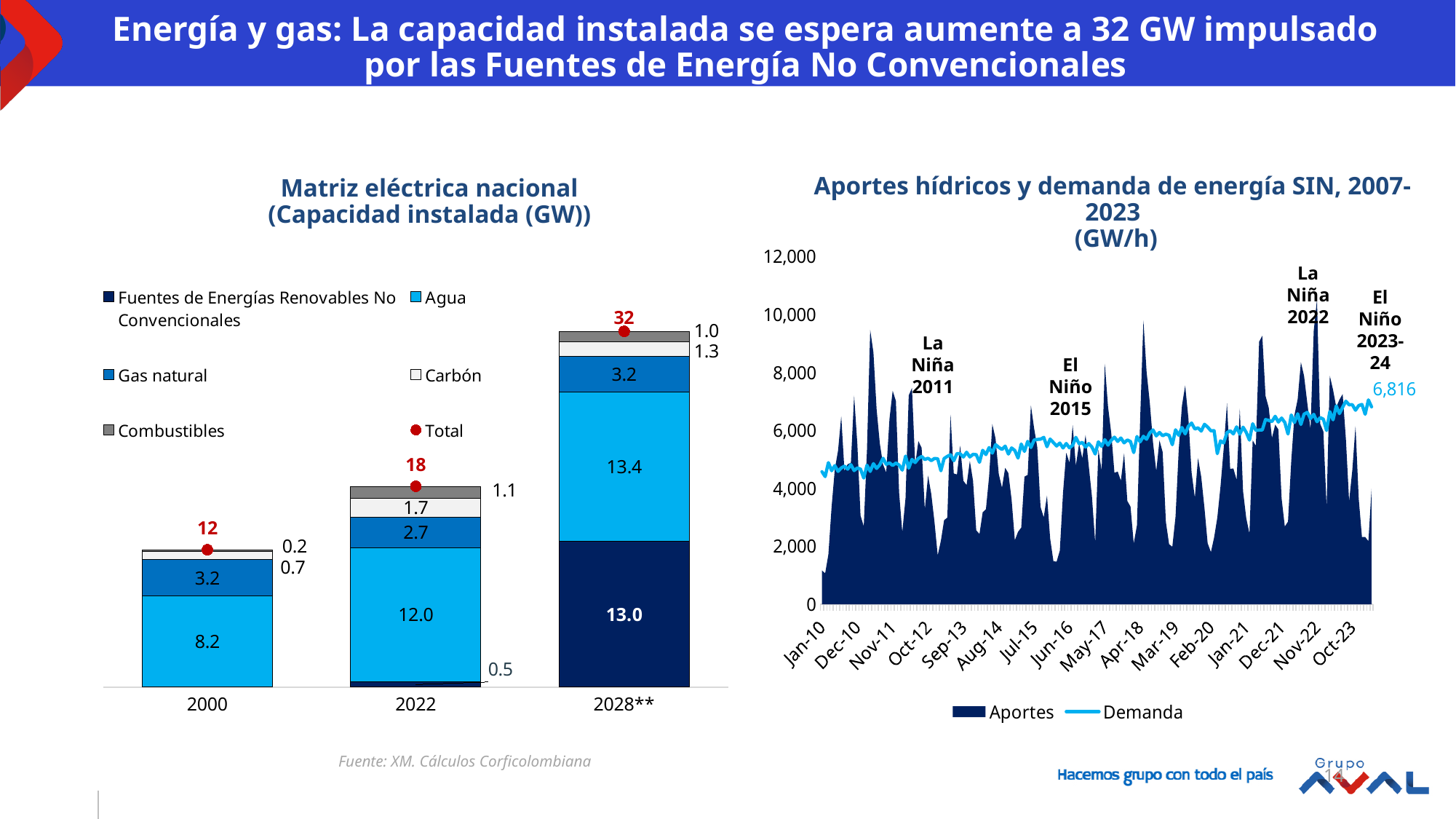
In the 'Aportes hídricos y demanda de energía SIN' chart, what is the last labelled value of the Demanda series? 6,816 In the 'Matriz eléctrica nacional' chart, what is the Total for 2000? 12 In the 'Matriz eléctrica nacional' chart, what is the difference between the Total for 2028** and the Total for 2022? 14 In the 'Matriz eléctrica nacional' chart, which is larger in 2028**: Agua or Fuentes de Energías Renovables No Convencionales? Agua What kind of chart is the 'Matriz eléctrica nacional' chart? Stacked bar chart How many entries does the legend of the 'Matriz eléctrica nacional' chart list? 6 In the 'Aportes hídricos y demanda de energía SIN' chart, does the Demanda series rise or fall from Jan-10 to Oct-23? Rises In the 'Matriz eléctrica nacional' chart, which year has the highest Total? 2028** In the 'Matriz eléctrica nacional' chart, what is the value for Agua in 2022? 12.0 In the 'Matriz eléctrica nacional' chart, what is the value for Carbón in 2022? 1.7 In the 'Matriz eléctrica nacional' chart, what is the value for Fuentes de Energías Renovables No Convencionales in 2028**? 13.0 How many years are shown on the x axis of the 'Matriz eléctrica nacional' chart? 3